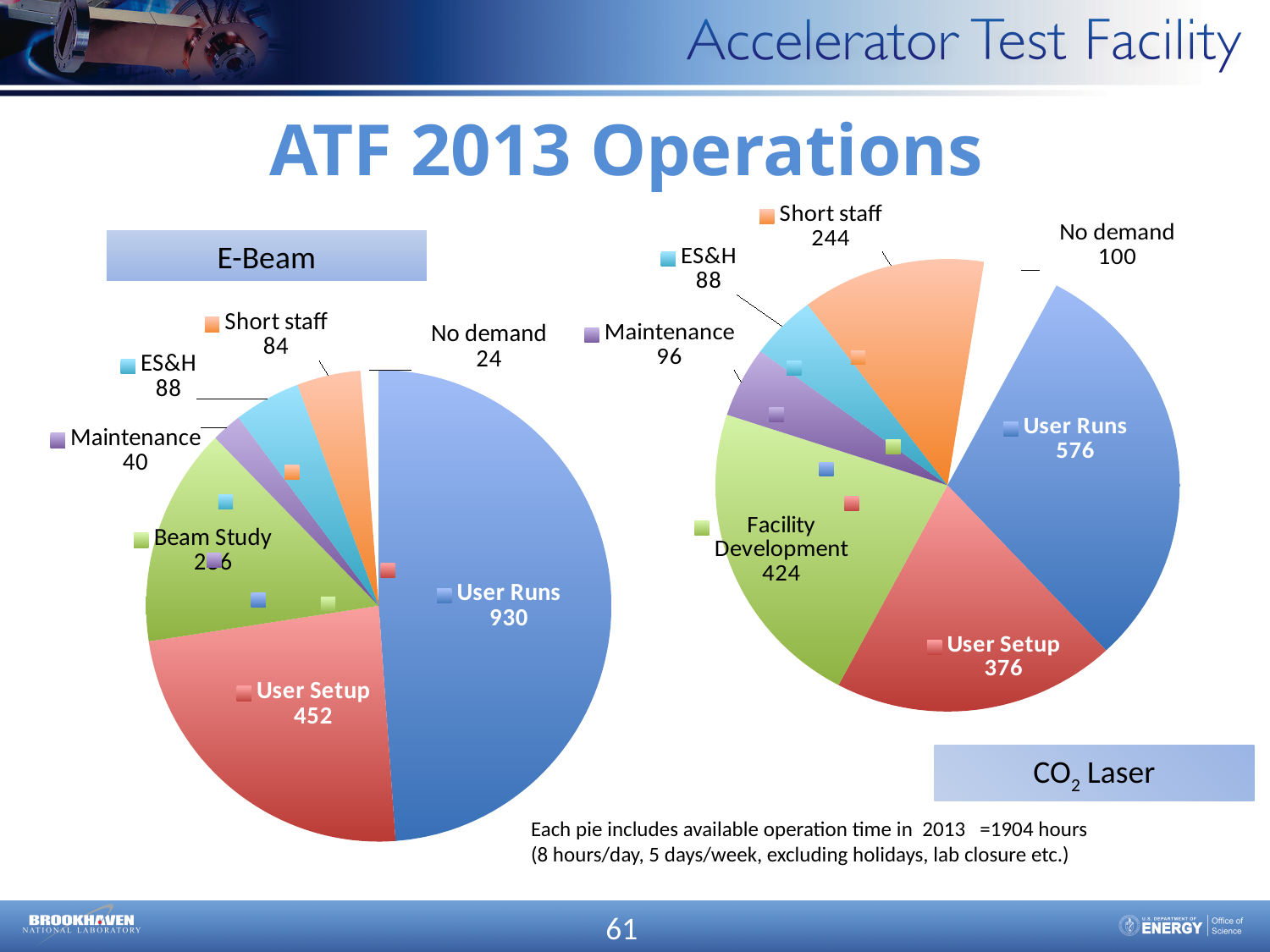
According to the note on the slide, how many hours of available operation time does each pie include for 2013? 1904 hours In the CO2 Laser pie chart, what is the difference between User Runs and User Setup? 200 In the CO2 Laser pie chart, what is the value for Short staff? 244 In the E-Beam pie chart, which category has the largest slice? User Runs How many categories does the CO2 Laser pie chart show? 7 In the CO2 Laser pie chart, which is larger, Facility Development or User Setup? Facility Development In the CO2 Laser pie chart, what is the value for Maintenance? 96 In the E-Beam pie chart, which category has the smallest slice? No demand What kind of chart is used for the E-Beam data? Pie chart In the E-Beam pie chart, what is the value for User Runs? 930 In the E-Beam pie chart, what is the difference between User Runs and User Setup? 478 In the CO2 Laser pie chart, which category has the smallest value? ES&H